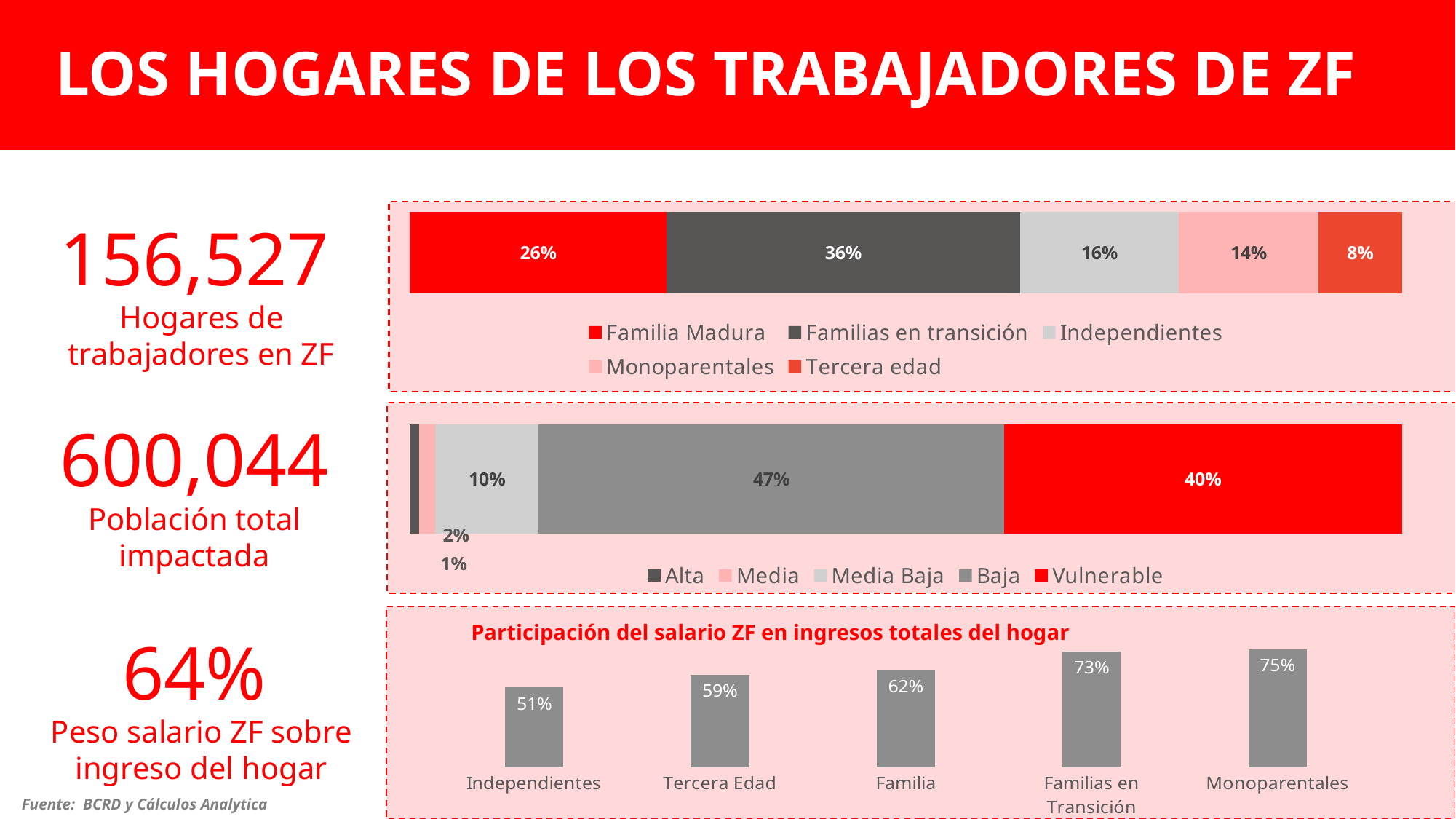
In the middle stacked bar chart, what share is labelled for Media Baja? 10% What kind of chart is the one titled 'Participación del salario ZF en ingresos totales del hogar'? Bar chart In the middle stacked bar chart, which is larger, Baja or Vulnerable? Baja In the chart titled 'Participación del salario ZF en ingresos totales del hogar', what is the difference between Monoparentales and Independientes? 24 percentage points In the middle stacked bar chart, what share is labelled for Baja? 47% In the top stacked bar chart, what share is labelled for Tercera edad? 8% In the chart titled 'Participación del salario ZF en ingresos totales del hogar', which category has the highest value? Monoparentales In the top stacked bar chart, which household type has the largest share? Familias en transición How many entries does the legend of the top stacked bar chart list? 5 In the chart titled 'Participación del salario ZF en ingresos totales del hogar', what is the value for Tercera Edad? 59% In the top stacked bar chart, what is the difference between the Familia Madura share and the Independientes share? 10 percentage points In the top stacked bar chart, what share is labelled for Familias en transición? 36%